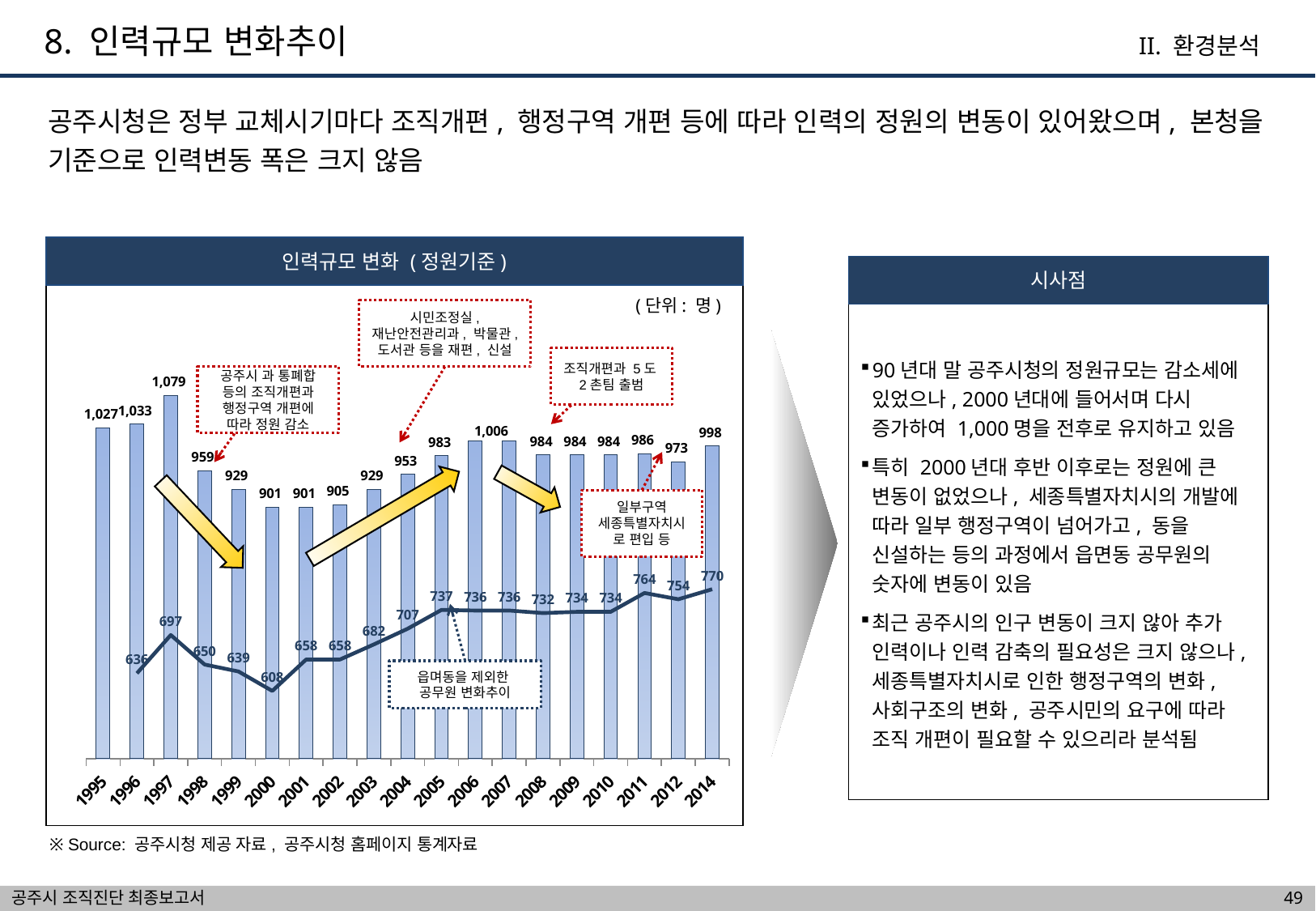
In which year does the line series reach its lowest value? 2000 How many years are shown on the x axis? 19 What is the line value for 2014? 770 Do the bar values rise or fall from 1997 to 2000? Fall What is the difference between the bar values for 1997 and 2000? 178 Which year has the highest bar value? 1997 What is the line value for 2000? 608 What kind of chart is shown under the title 인력규모 변화 (정원기준)? A bar chart with a line series Which year has the larger bar value, 1995 or 1996? 1996 What is the bar value for 2006? 1,006 What is the bar value for 1997? 1,079 What is the bar value for 2014? 998